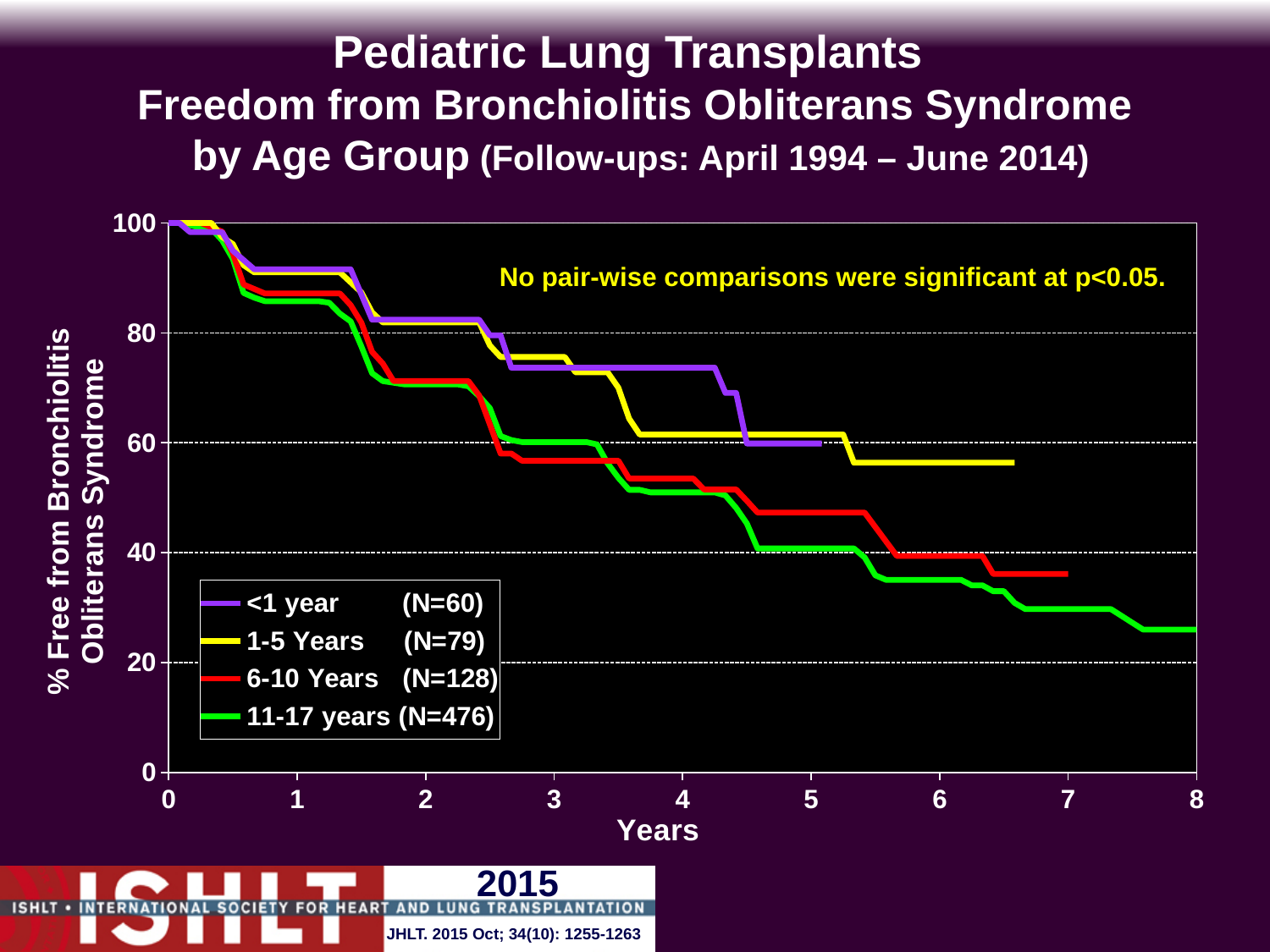
According to the legend, what is the N for the 6-10 Years group? N=128 Do the curves rise or fall as the years increase along the x axis? Fall At year 4, which is higher: the 1-5 Years curve or the 11-17 years curve? 1-5 Years Is the value for the 11-17 years group at year 4 greater or less than 60? less Is the value for the 1-5 Years group at year 6 greater or less than 40? greater At year 5, which age group has the lowest freedom from bronchiolitis obliterans syndrome? 11-17 years Is the value for the <1 year group at year 1 greater or less than 80? greater How many series does the legend list? 4 At year 5, which is higher: the 1-5 Years curve or the 6-10 Years curve? 1-5 Years What kind of chart is shown on the slide? Line chart